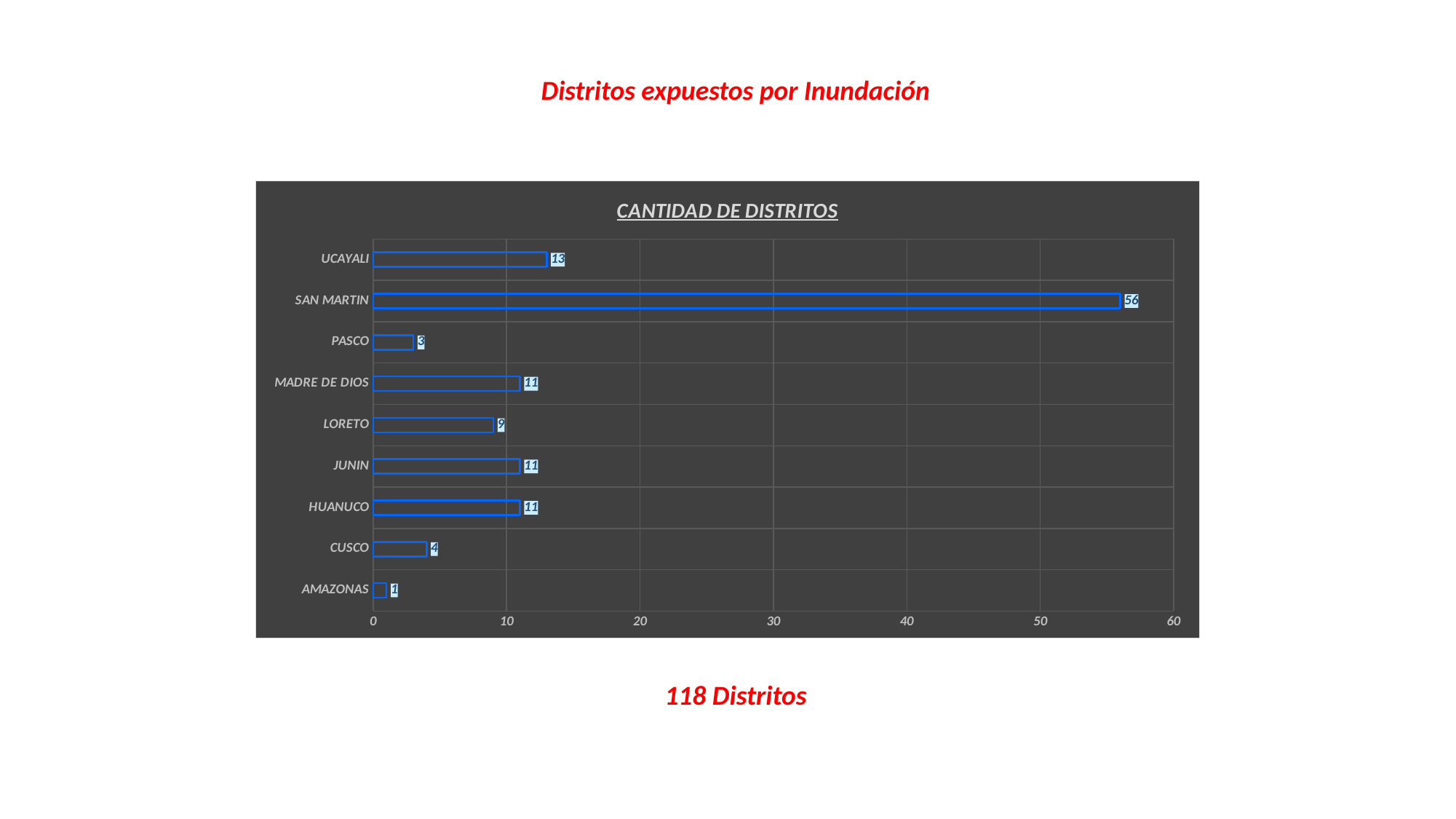
What is the title of the chart? CANTIDAD DE DISTRITOS What kind of chart is shown? bar chart Which is larger, the value for PASCO or the value for CUSCO? CUSCO How many categories are shown on the chart? 9 Is the value for SAN MARTIN greater or less than 50? greater What is the value for CUSCO? 4 What is the value for UCAYALI? 13 Which category has the highest value? SAN MARTIN What is the value for SAN MARTIN? 56 What is the difference between the values for SAN MARTIN and UCAYALI? 43 What is the value for LORETO? 9 Which category has the lowest value? AMAZONAS